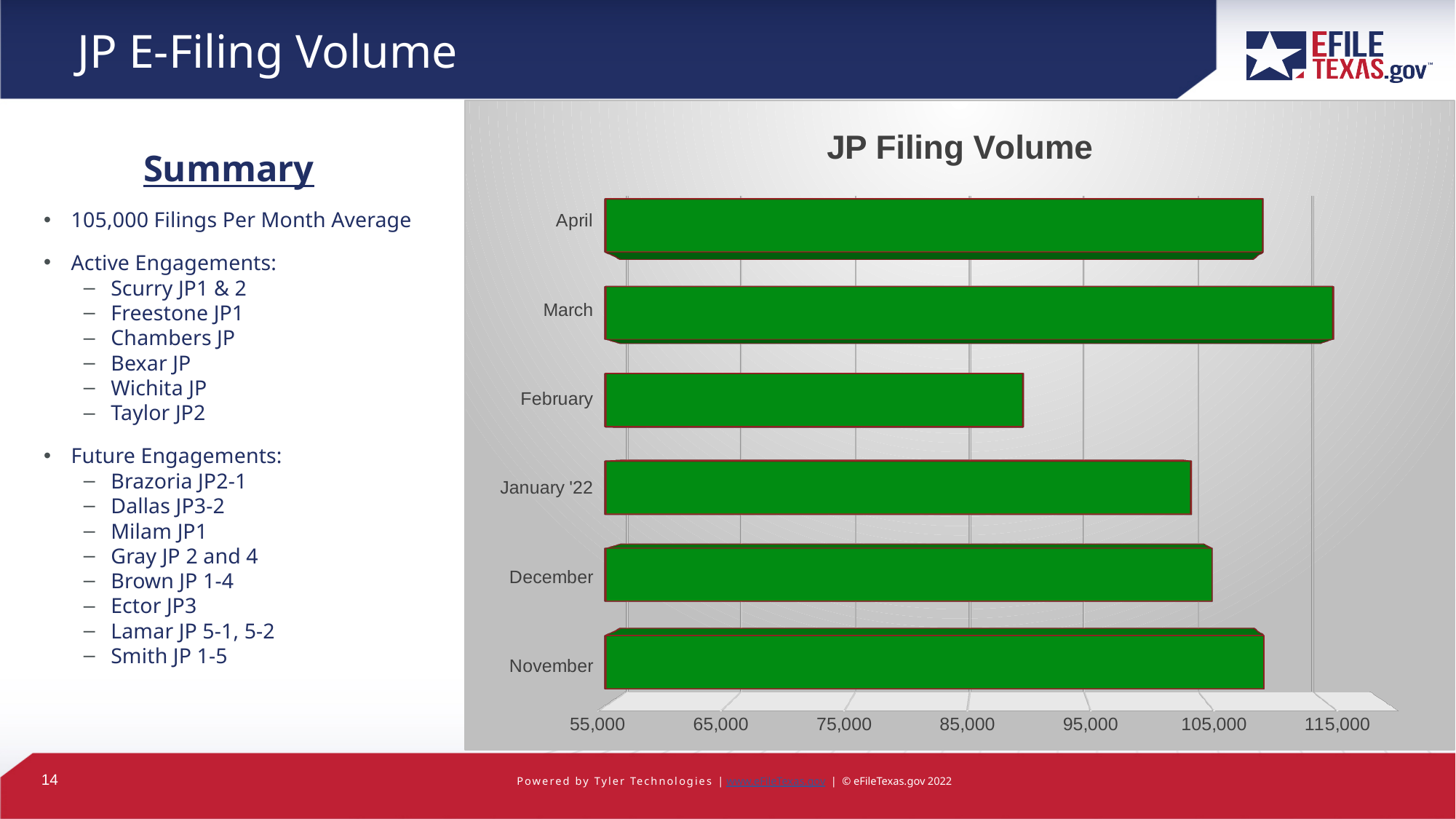
Which has the larger filing volume, March or February? March Is the filing volume for April greater or less than 105,000? greater What kind of chart is shown on the slide? bar chart How many months are plotted in the chart? 6 What colour are the bars in the chart? green Which has the larger filing volume, January '22 or February? January '22 Which month has the highest filing volume? March Which month has the lowest filing volume? February Is the filing volume for January '22 greater or less than 95,000? greater Is the filing volume for March greater or less than 105,000? greater What is the title of the chart? JP Filing Volume